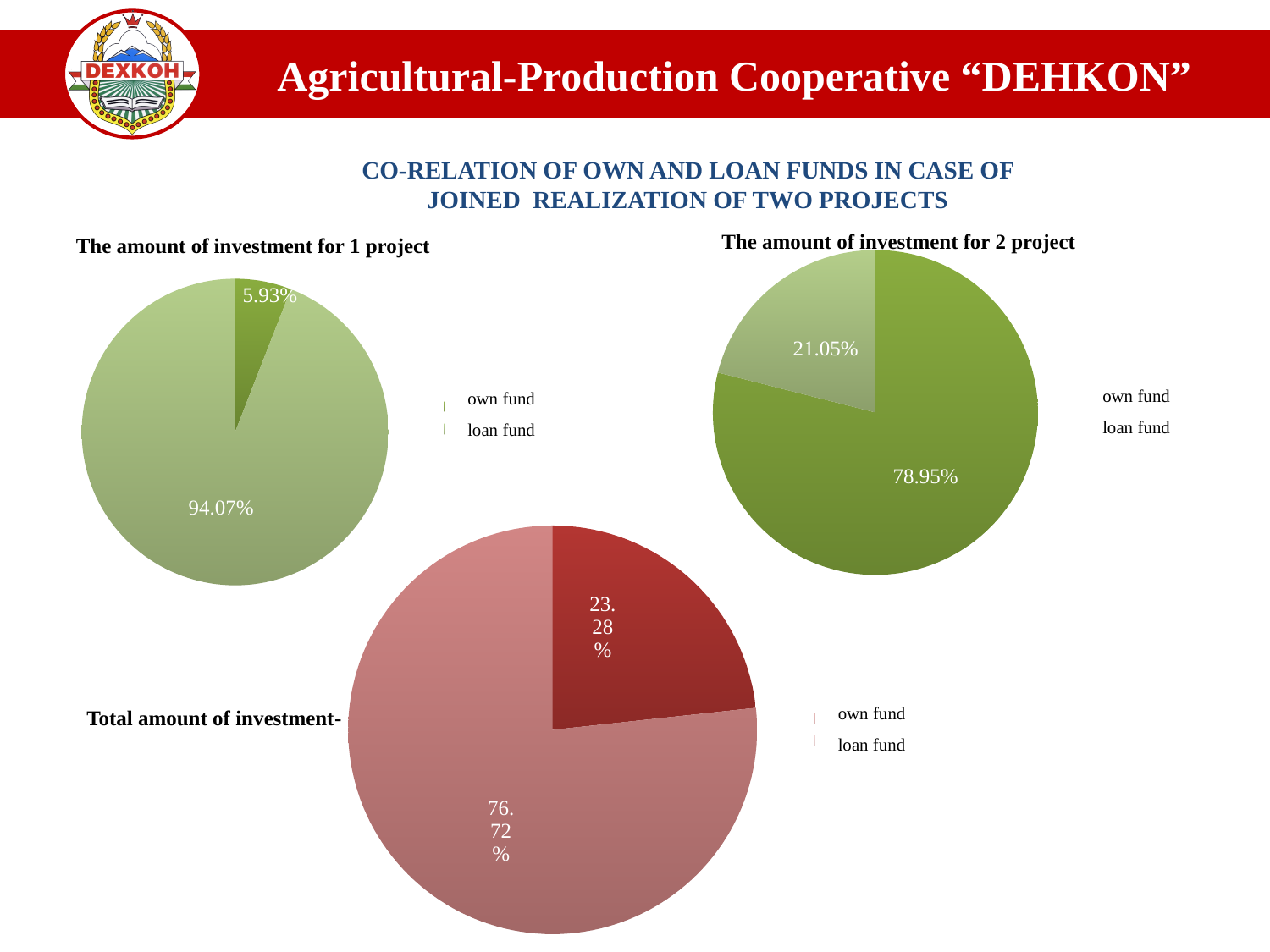
In the chart "The amount of investment for 1 project", what is the value of the smallest slice? 5.93% What type of chart is used for "The amount of investment for 1 project"? pie chart How many entries does the legend of "The amount of investment for 2 project" list? 2 In the chart "The amount of investment for 2 project", what is the difference between the two slices? 57.9% In the chart "The amount of investment for 1 project", what is the difference between the two slices? 88.14% In the chart "The amount of investment for 1 project", what is the value of the largest slice? 94.07% In the chart "The amount of investment for 2 project", what is the value of the largest slice? 78.95% How many pie charts are shown on the slide? 3 In the chart "Total amount of investment-", what is the value of the smaller slice? 23.28% In the chart "The amount of investment for 2 project", what is the value of the smaller slice? 21.05% In the chart "Total amount of investment-", what is the value of the larger slice? 76.72% How many slices does the chart "Total amount of investment-" have? 2